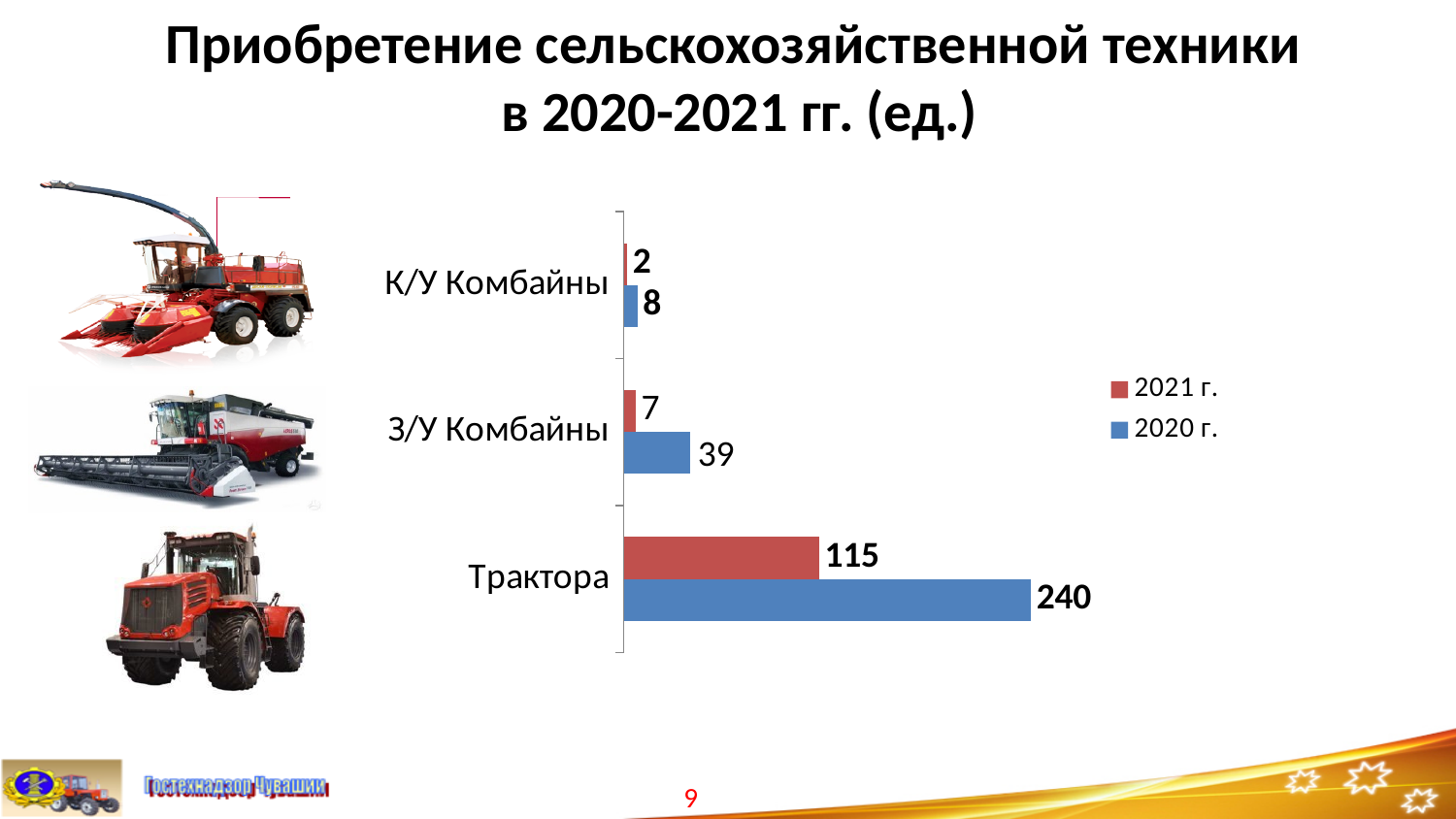
How many series does the legend list? 2 What is the difference between the 2020 г. and 2021 г. values for З/У Комбайны? 32 What is the value for З/У Комбайны in 2020 г.? 39 What is the value for Трактора in 2020 г.? 240 How many categories are shown on the chart? 3 Which category has the highest value in 2020 г.? Трактора Which is larger for К/У Комбайны: the 2020 г. value or the 2021 г. value? 2020 г. What is the value for К/У Комбайны in 2021 г.? 2 What kind of chart is shown on the slide? Bar chart Which category has the lowest value in 2021 г.? К/У Комбайны What is the difference between the 2020 г. and 2021 г. values for Трактора? 125 What is the value for Трактора in 2021 г.? 115